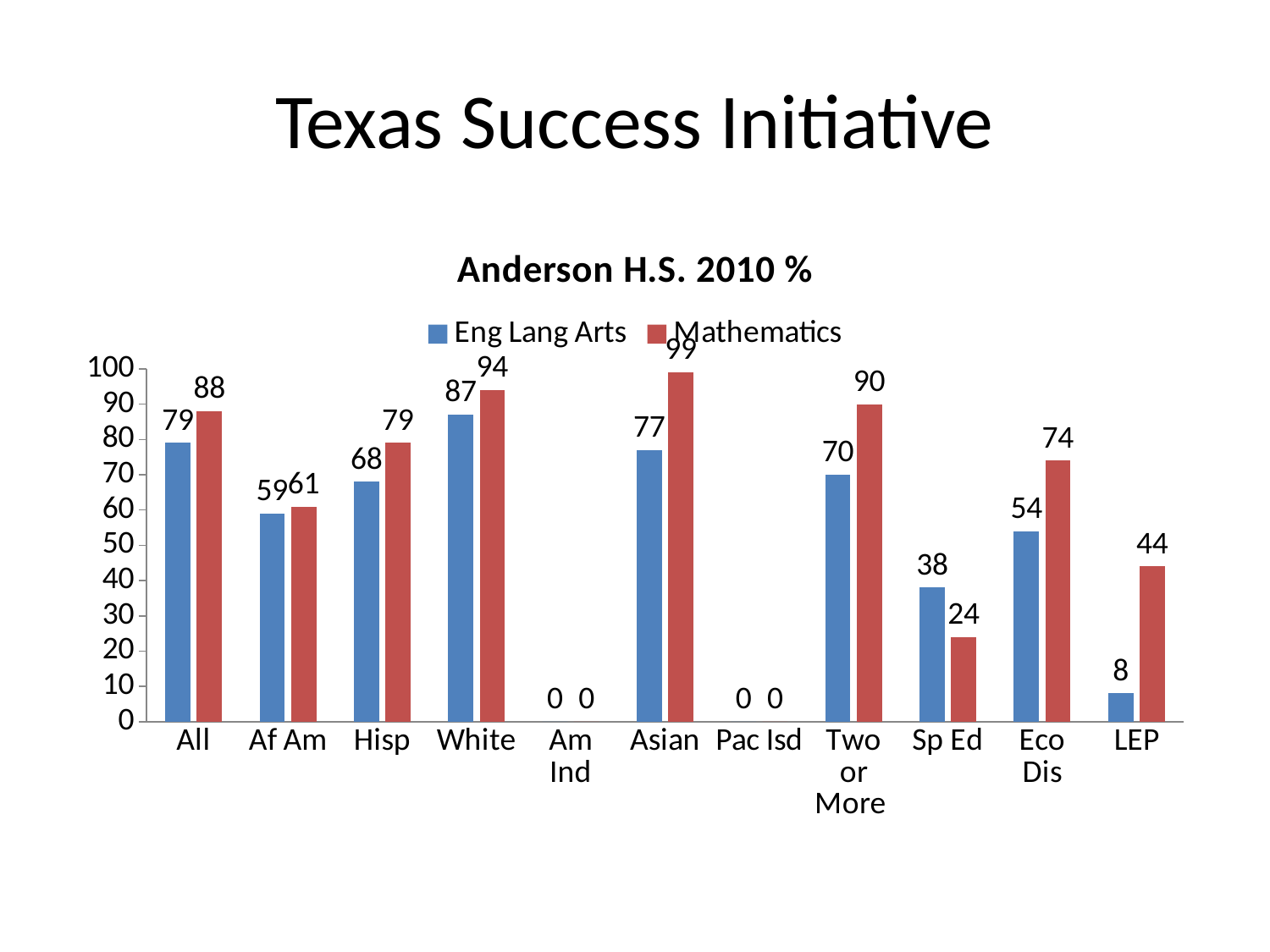
What is the Eng Lang Arts value for All? 79 How many series does the legend list? 2 What is the difference between the Eng Lang Arts values for White and Af Am? 28 What is the Mathematics value for Asian? 99 What is the Eng Lang Arts value for Sp Ed? 38 What is the difference between the Mathematics and Eng Lang Arts values for LEP? 36 Which category has the highest Mathematics value? Asian How many categories are shown on the x axis? 11 What type of chart is shown? Bar chart Which category has the highest Eng Lang Arts value? White For Sp Ed, which is larger: Eng Lang Arts or Mathematics? Eng Lang Arts What is the Mathematics value for LEP? 44